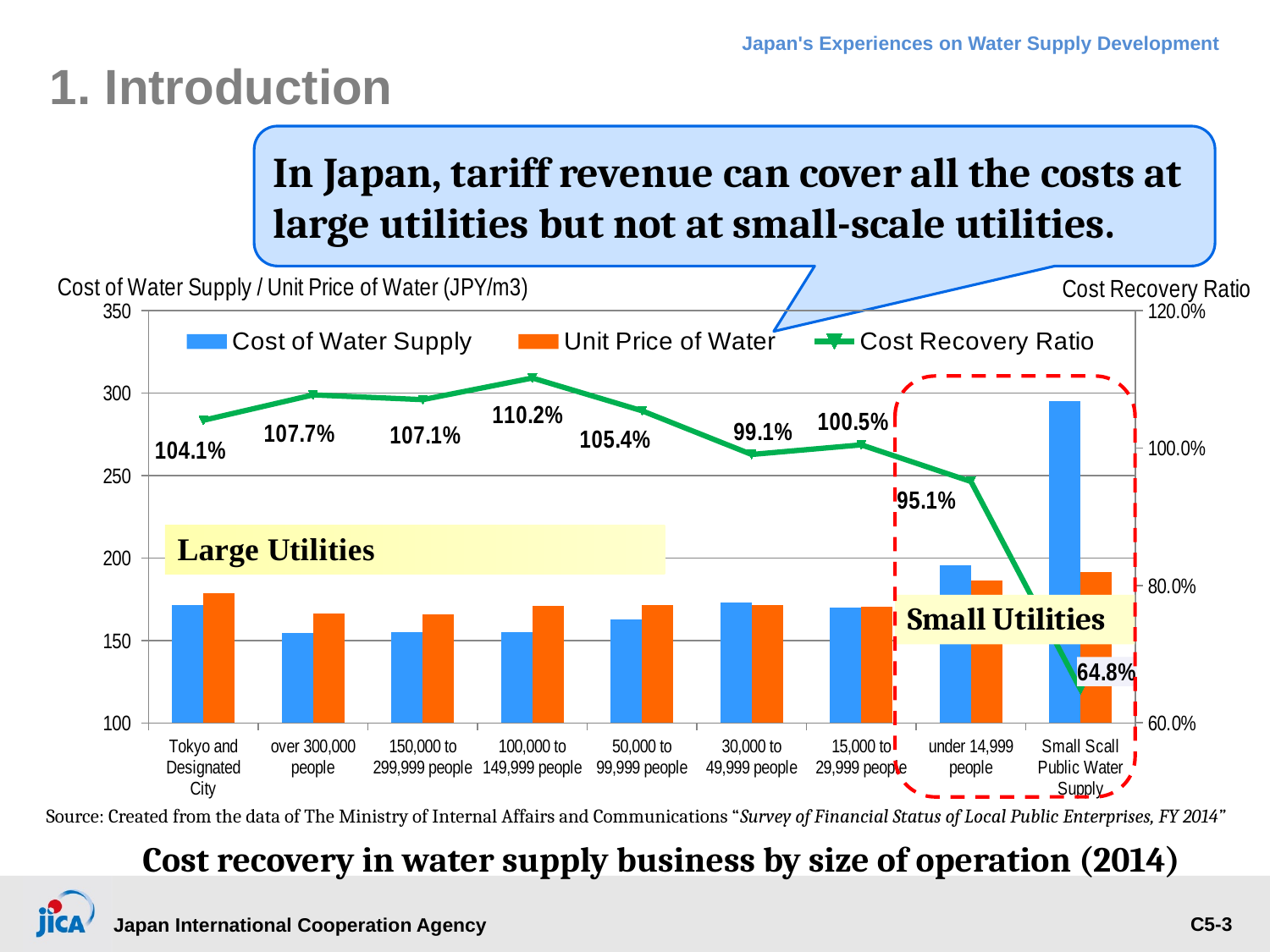
What is the Cost Recovery Ratio for the 'Tokyo and Designated City' category? 104.1% For 'Small Scall Public Water Supply', which bar is taller: Cost of Water Supply or Unit Price of Water? Cost of Water Supply Does the Cost Recovery Ratio rise or fall from '100,000 to 149,999 people' to 'Small Scall Public Water Supply'? fall Which category has the lowest Cost Recovery Ratio? Small Scall Public Water Supply Which category has the highest Cost Recovery Ratio? 100,000 to 149,999 people What is the Cost Recovery Ratio for 'Small Scall Public Water Supply'? 64.8% What is the Cost Recovery Ratio for the 'under 14,999 people' category? 95.1% How many series does the legend list? 3 What is the difference in Cost Recovery Ratio between '100,000 to 149,999 people' and 'Small Scall Public Water Supply'? 45.4 percentage points How many categories are shown on the x axis? 9 Is the Cost of Water Supply for 'Small Scall Public Water Supply' greater or less than 250? greater Which has a higher Cost Recovery Ratio: 'over 300,000 people' or '30,000 to 49,999 people'? over 300,000 people